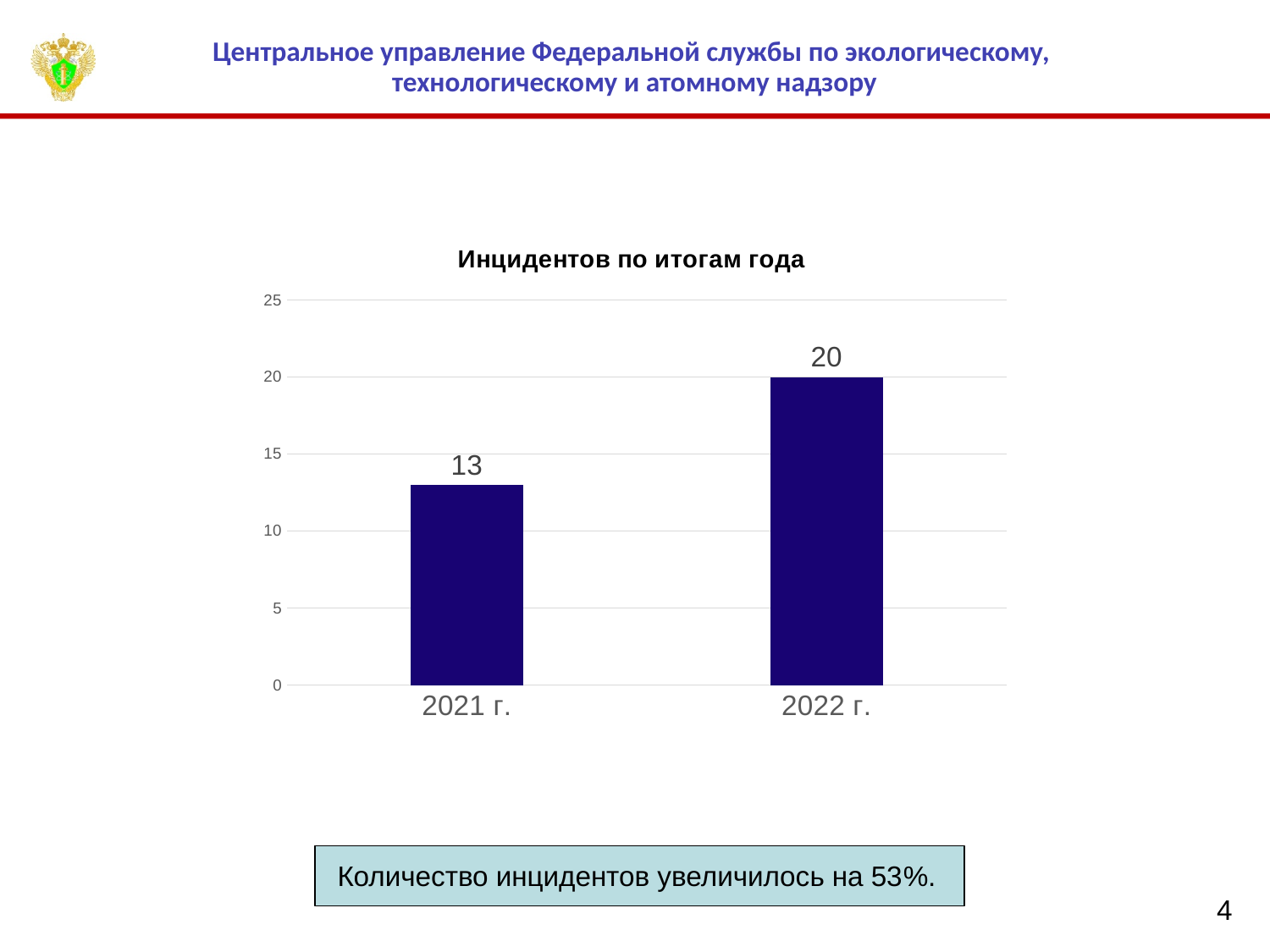
What is the title of the chart? Инцидентов по итогам года What is the value for 2021 г.? 13 Do the values rise or fall from 2021 г. to 2022 г.? rise What is the value for 2022 г.? 20 What is the difference between the values for 2022 г. and 2021 г.? 7 What kind of chart is shown on the slide? bar chart How many categories are shown on the x axis? 2 Which is larger, the value for 2021 г. or the value for 2022 г.? 2022 г. Is the value for 2021 г. greater or less than 15? less Which year has the lowest number of incidents? 2021 г. What is the maximum value shown on the vertical axis? 25 Which year has the highest number of incidents? 2022 г.